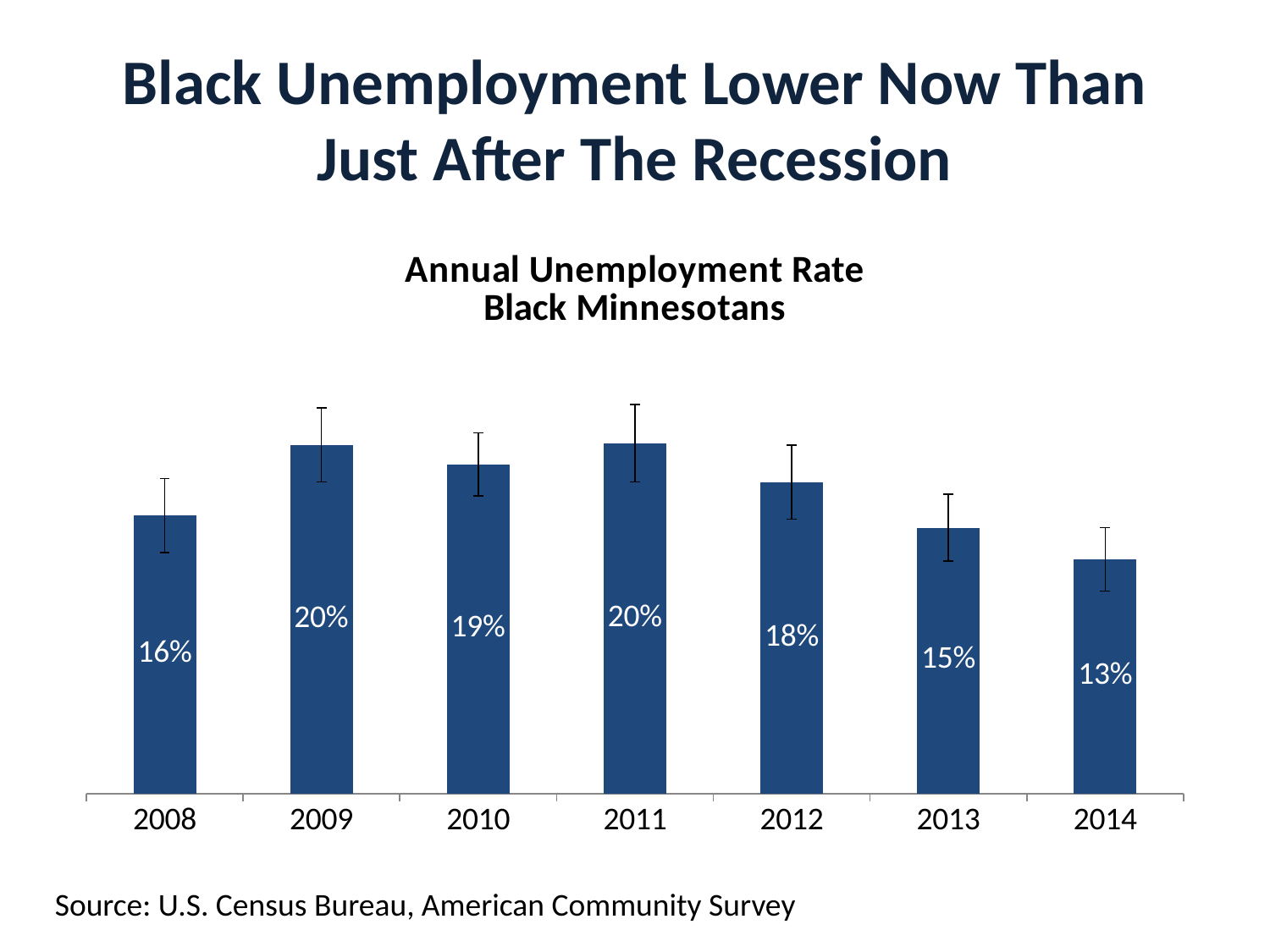
What is the difference in percentage points between the 2009 and 2014 unemployment rates? 7 percentage points How many years are shown on the chart? 7 What was the annual unemployment rate for Black Minnesotans in 2008? 16% What was the annual unemployment rate for Black Minnesotans in 2012? 18% What kind of chart is shown on the slide? Bar chart Which year had a higher unemployment rate, 2008 or 2013? 2008 Which year has the lowest unemployment rate shown on the chart? 2014 What was the annual unemployment rate for Black Minnesotans in 2014? 13% Does the unemployment rate rise or fall from 2011 to 2014? Fall Which year had a higher unemployment rate, 2010 or 2012? 2010 What was the annual unemployment rate for Black Minnesotans in 2010? 19% What is the difference in percentage points between the 2012 and 2013 unemployment rates? 3 percentage points